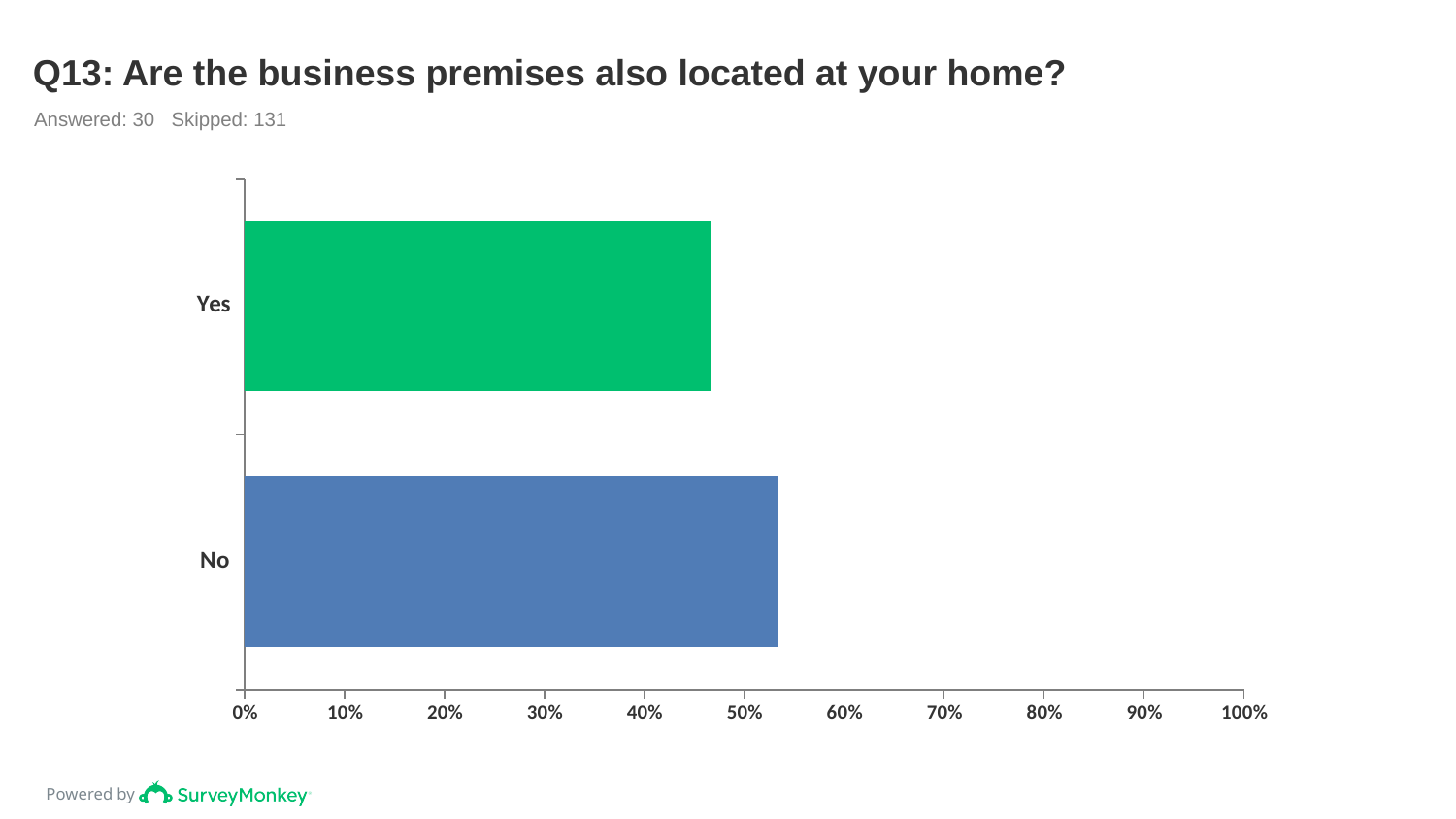
What kind of chart is shown on the slide? bar chart Is the value for No greater or less than 50%? greater Which category has the highest value? No Which is larger, the value for Yes or the value for No? No How many categories are plotted in the chart? 2 Is the value for Yes greater or less than 40%? greater Is the value for Yes greater or less than 50%? less How many respondents answered this question according to the slide? 30 Which category has the lowest value? Yes What is the title of the chart? Q13: Are the business premises also located at your home?